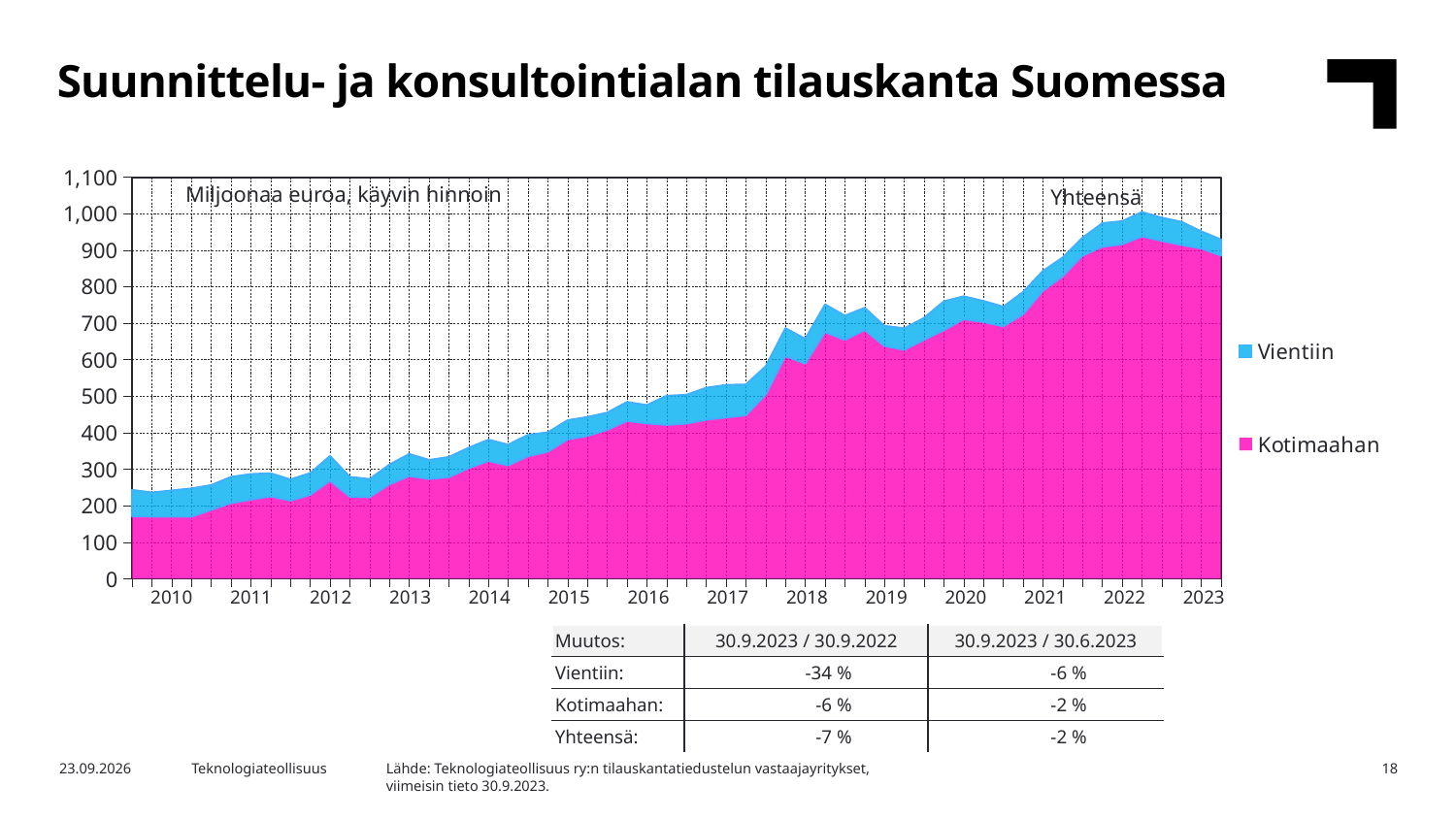
Is the Kotimaahan value at the start of 2017 greater or less than 500? less What unit label is printed inside the chart area at the top left? Miljoonaa euroa, käyvin hinnoin Does the total order backlog generally rise or fall from 2010 to 2023? rise How many series does the chart legend list? 2 In which year does the total (Yhteensä) reach its highest point? 2022 What kind of chart is shown on the slide? Stacked area chart Is the total (Yhteensä) value at the end of 2023 greater or less than 800? greater Is the Kotimaahan value at the start of 2010 greater or less than 200? less Which two series are listed in the chart legend? Vientiin and Kotimaahan Which series is larger throughout the chart, Vientiin or Kotimaahan? Kotimaahan